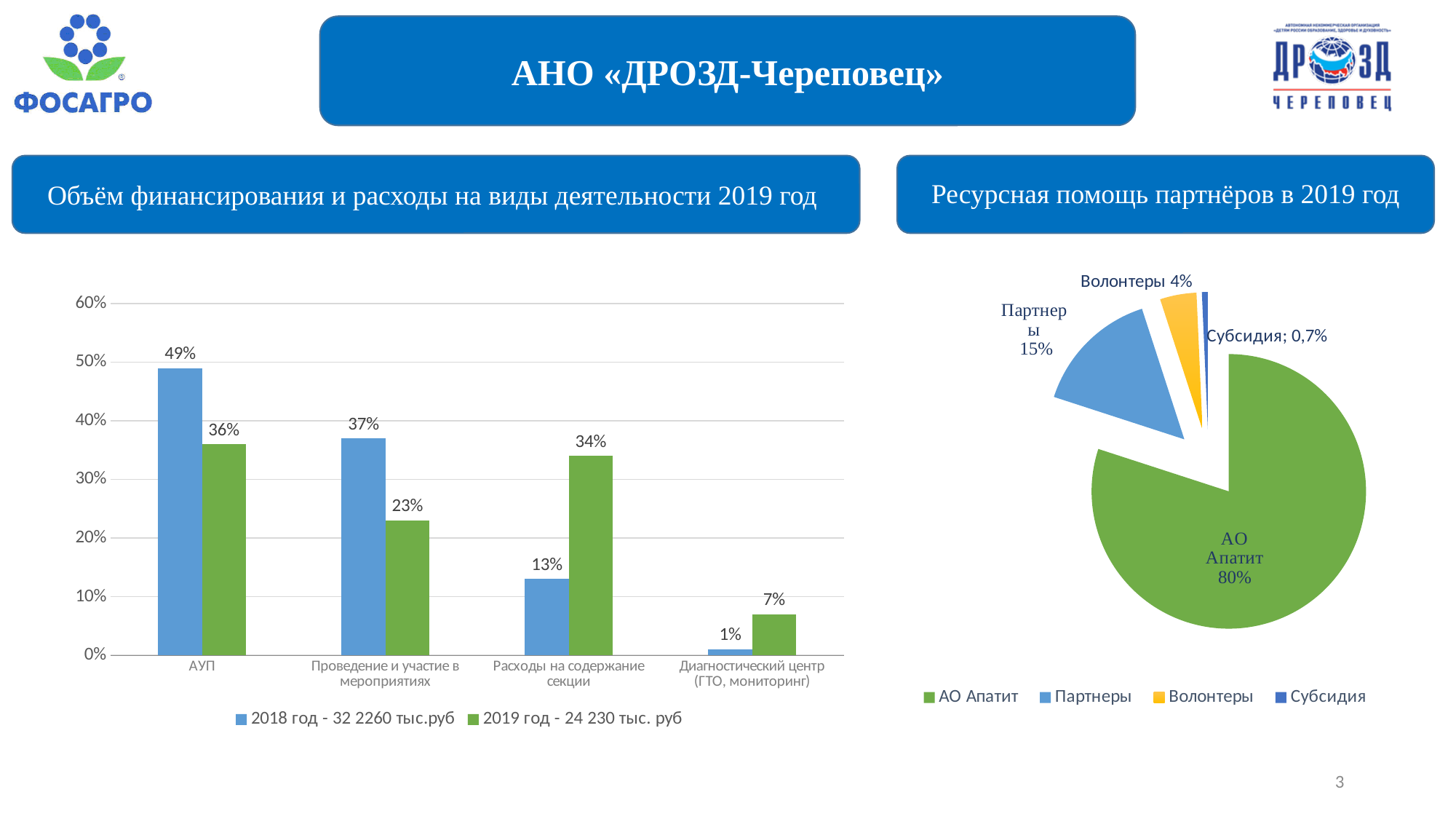
In the pie chart on the right, what is the value for Субсидия? 0,7% In the pie chart on the right, which slice is the smallest? Субсидия In the bar chart on the left, which category has the lowest 2018 value? Диагностический центр (ГТО, мониторинг) In the bar chart on the left, is the 2018 or the 2019 value larger for Расходы на содержание секции? 2019 In the bar chart on the left, what is the 2019 value for Расходы на содержание секции? 34% In the bar chart on the left, which category has the highest 2019 value? АУП In the bar chart on the left, what is the 2018 value for АУП? 49% In the pie chart on the right, what share does АО Апатит have? 80% What type of chart is the chart on the right, titled 'Ресурсная помощь партнёров в 2019 год'? pie chart How many categories are shown on the x axis of the bar chart on the left? 4 How many series does the legend of the bar chart on the left list? 2 In the bar chart on the left, what is the difference between the 2018 and 2019 values for Проведение и участие в мероприятиях? 14%